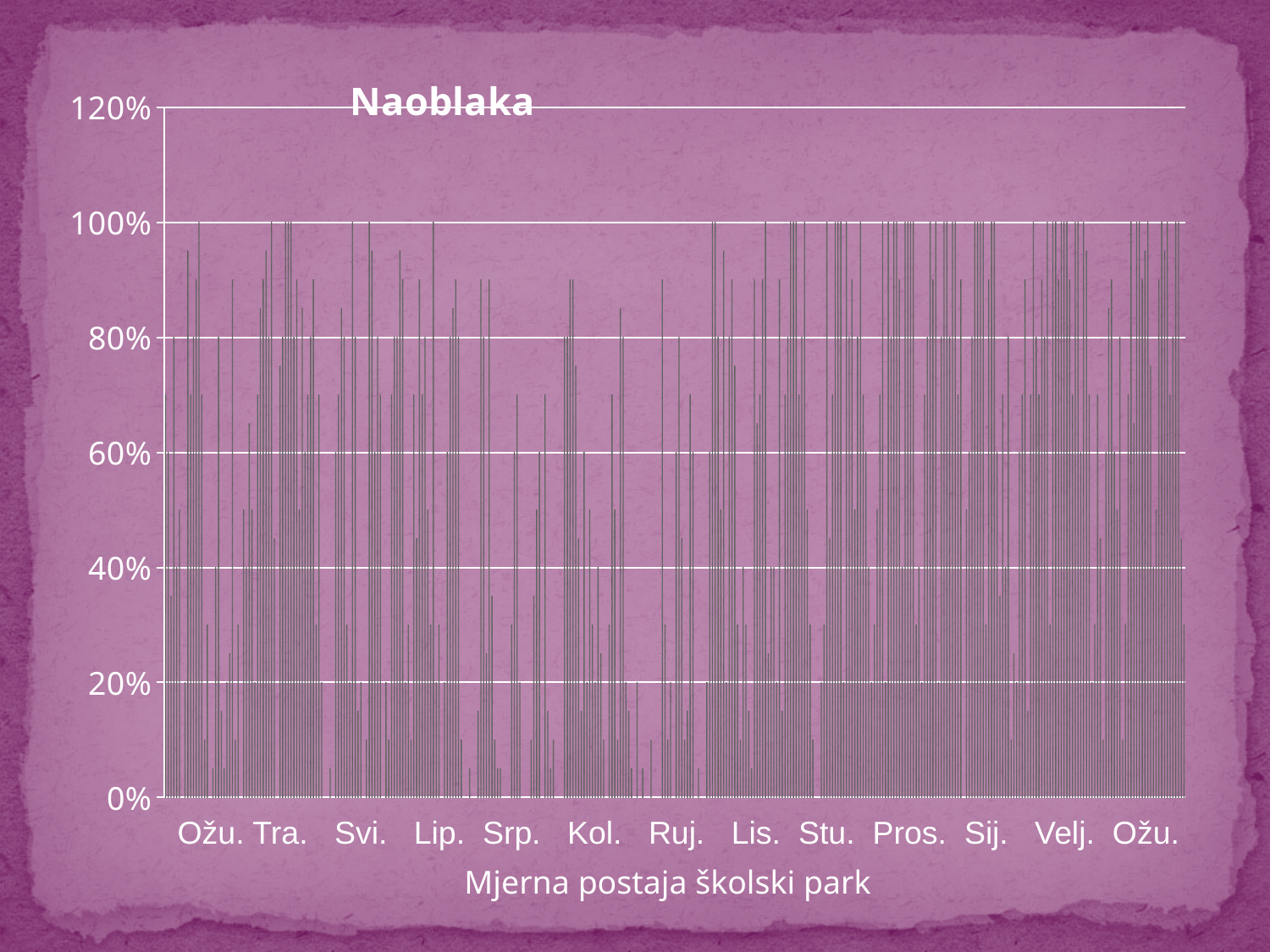
What is the first month label on the x axis of the chart? Ožu. How many month labels are shown along the x axis of the chart? 13 Which month label comes immediately after Lis. on the x axis? Stu. What is the title of the chart? Naoblaka What is the last month label on the x axis of the chart? Ožu. Do any bars in the chart exceed the 100% gridline? No What is the x-axis title of the chart? Mjerna postaja školski park What kind of chart is shown on the slide? bar chart What is the highest tick value shown on the y axis of the chart? 120% What is the lowest tick value shown on the y axis of the chart? 0%